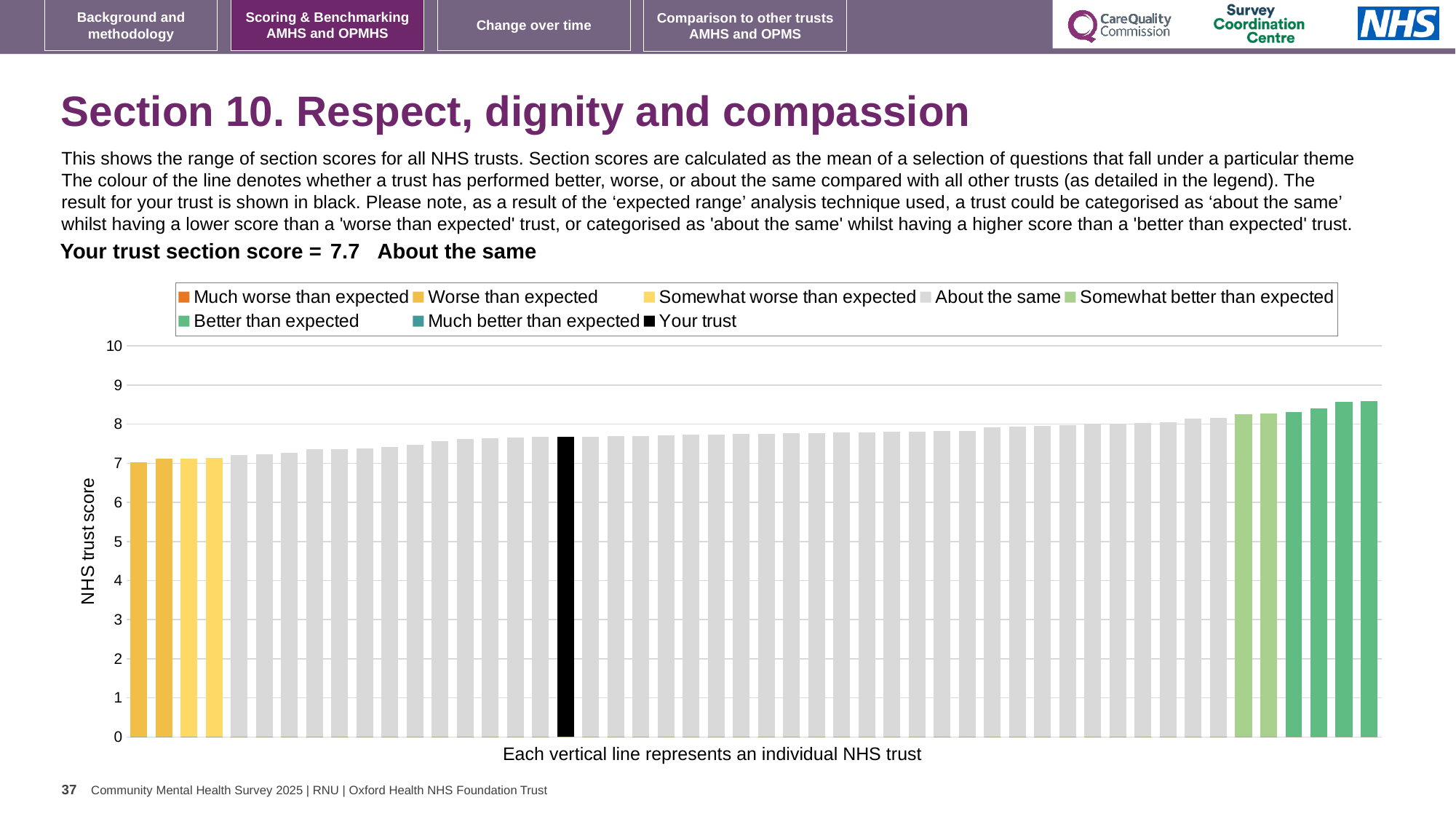
Is the value for your trust (the black bar) greater or less than 8? less Is the value of the rightmost (highest) bar greater or less than 9? less Which is larger, the leftmost bar or the rightmost bar? the rightmost bar Do the bar values rise or fall from left to right along the x axis? rise What kind of chart is shown on the slide? bar chart What colour is used for the bar representing your trust? black Is the value for your trust (the black bar) greater or less than 7? greater What is the label on the vertical axis of the chart? NHS trust score How many entries does the chart legend list? 8 What is the section score for your trust shown on the slide? 7.7 Which category is your trust's section score placed in? About the same